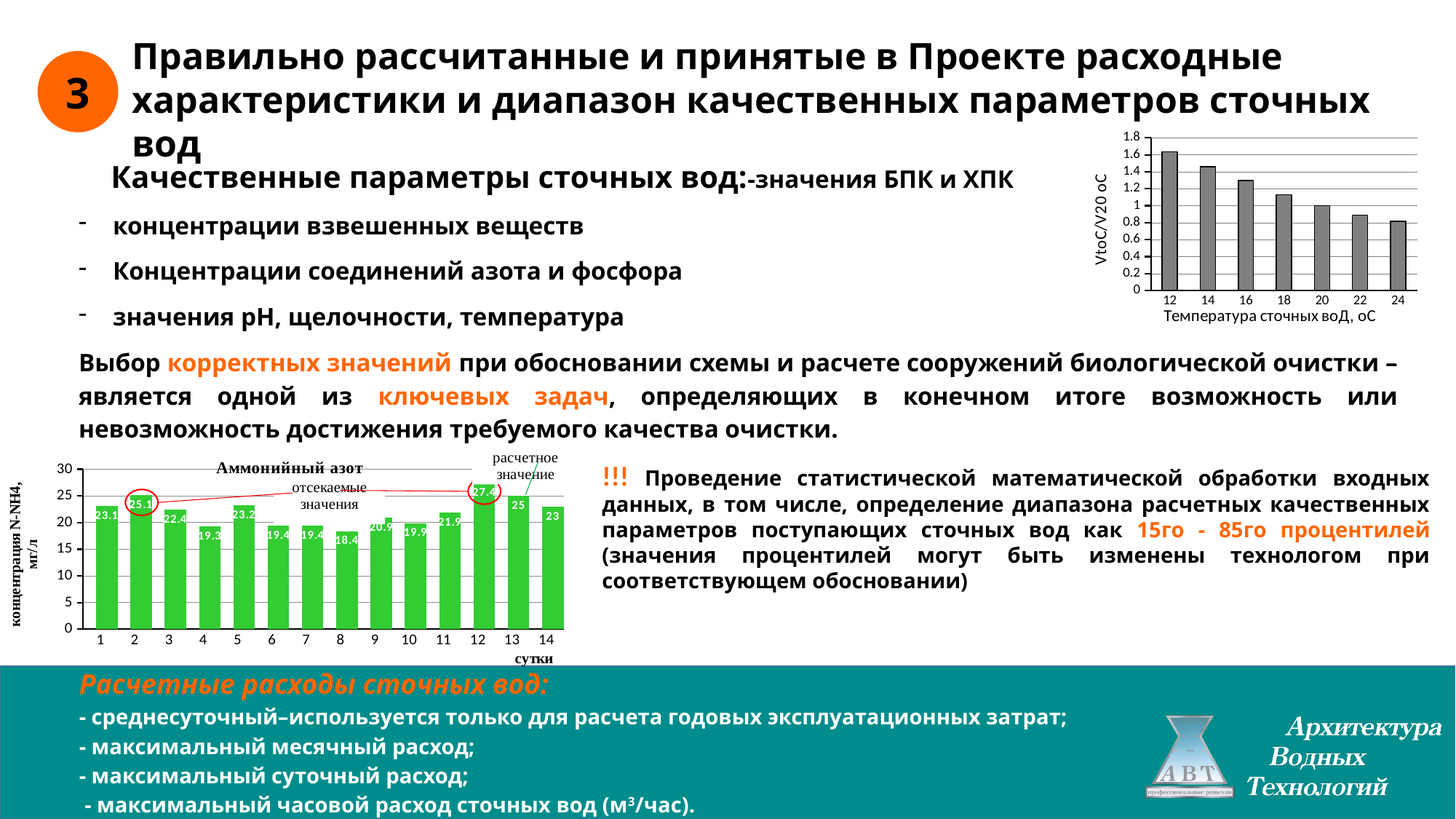
How many temperature categories are shown in the top-right chart (VtoC/V20 vs temperature)? 7 How many days (bars) are shown in the 'Аммонийный азот' chart? 14 In the 'Аммонийный азот' chart, what is the difference between the values for day 12 and day 8? 9 In the top-right chart (VtoC/V20 vs temperature), is the value for 12 °C greater or less than 1.4? greater In the 'Аммонийный азот' chart, what is the value for day 8? 18.4 In the 'Аммонийный азот' chart, which day has the highest value? 12 In the 'Аммонийный азот' chart, what is the value for day 12? 27.4 In the 'Аммонийный азот' chart, which day has the lowest value? 8 In the top-right chart (VtoC/V20 vs temperature), is the value for 24 °C greater or less than 1? less In the 'Аммонийный азот' chart, which is larger: the value for day 2 or the value for day 13? day 2 What type of chart is the 'Аммонийный азот' chart? bar chart In the top-right chart (VtoC/V20 vs temperature), do the values rise or fall as temperature increases? fall